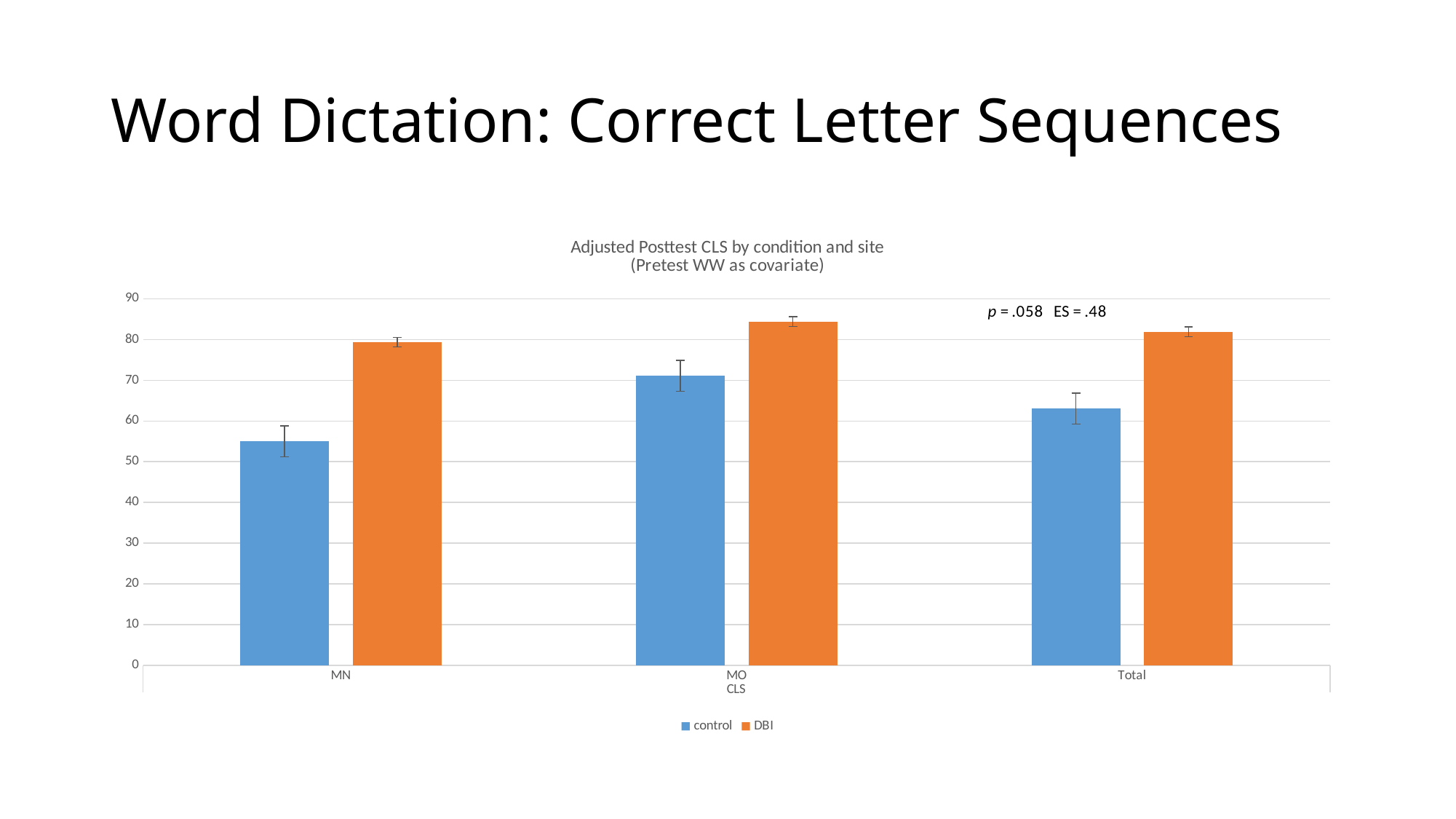
Is the DBI value for MO greater or less than 80? greater Which category has the lowest control bar? MN How many series does the legend list? 2 Is the DBI value for Total greater or less than 90? less Which category has the highest control bar? MO How many categories are shown on the x axis? 3 What is the title of the chart? Adjusted Posttest CLS by condition and site (Pretest WW as covariate) What kind of chart is shown on the slide? bar chart Is the control value for MO greater or less than 60? greater For MN, which is larger, the control bar or the DBI bar? DBI Which category has the lowest DBI bar? MN